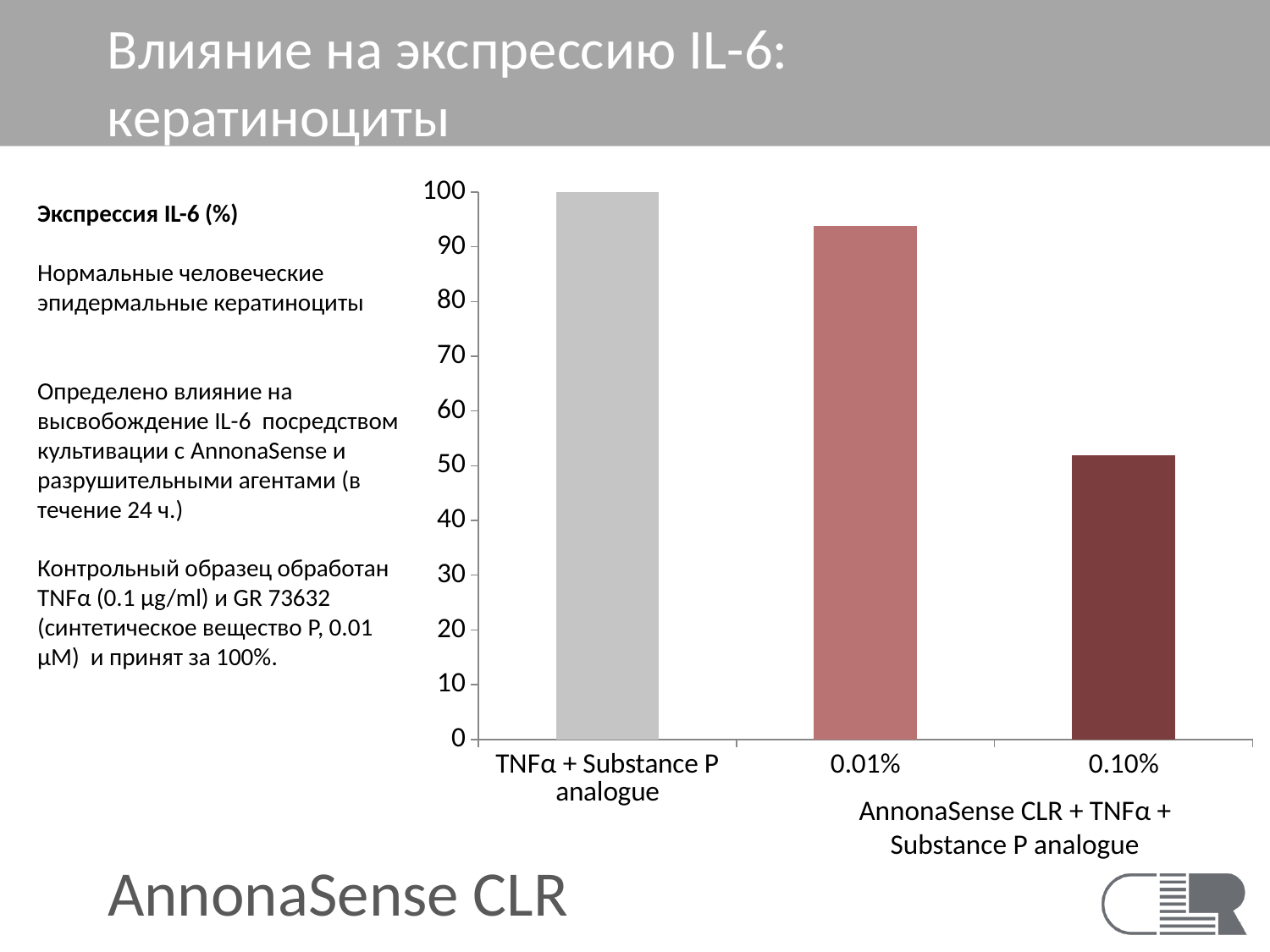
What kind of chart is shown on the slide? bar chart Is the value for 0.01% greater or less than 90? greater Which category has the highest value? TNFα + Substance P analogue What is the maximum value shown on the vertical axis? 100 Which category has the lowest value? 0.10% Do the values rise or fall from left to right across the categories? fall Which is larger, the value for 0.01% or the value for 0.10%? 0.01% How many bars are plotted in the chart? 3 What label is printed under the 0.01% and 0.10% bars? AnnonaSense CLR + TNFα + Substance P analogue Is the value for 0.10% greater or less than 60? less What is the value for TNFα + Substance P analogue? 100